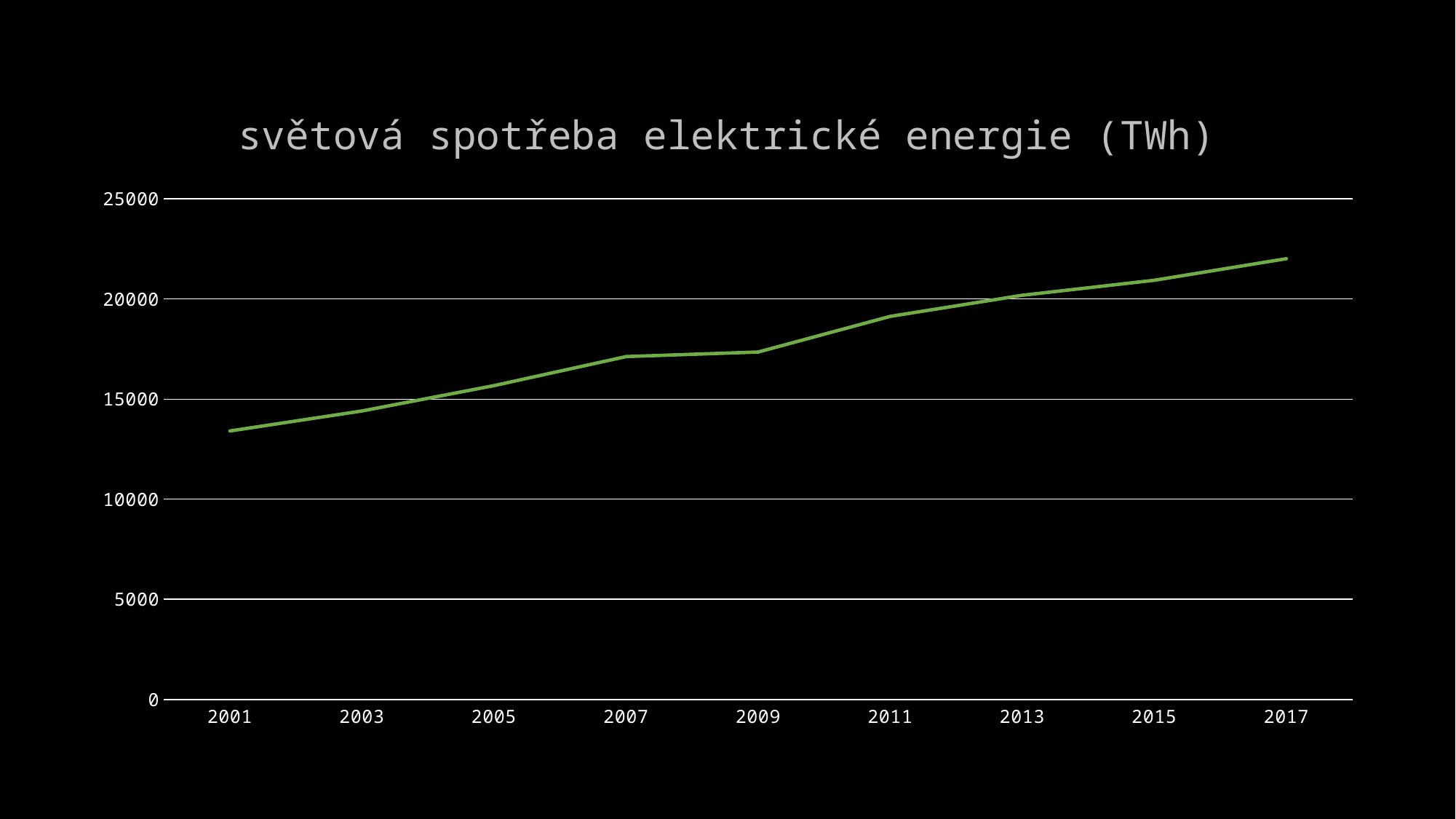
Is the value for 2017 greater or less than 20000? greater What is the title of the chart? světová spotřeba elektrické energie (TWh) Do the values rise or fall from 2001 to 2017? rise Is the value for 2007 greater or less than 20000? less Which year has the highest value on the chart? 2017 How many years are labelled on the x axis of the chart? 9 Is the value for 2001 greater or less than 15000? less What kind of chart is shown on the slide? line chart Which is larger, the value for 2005 or the value for 2015? 2015 Which year has the lowest value on the chart? 2001